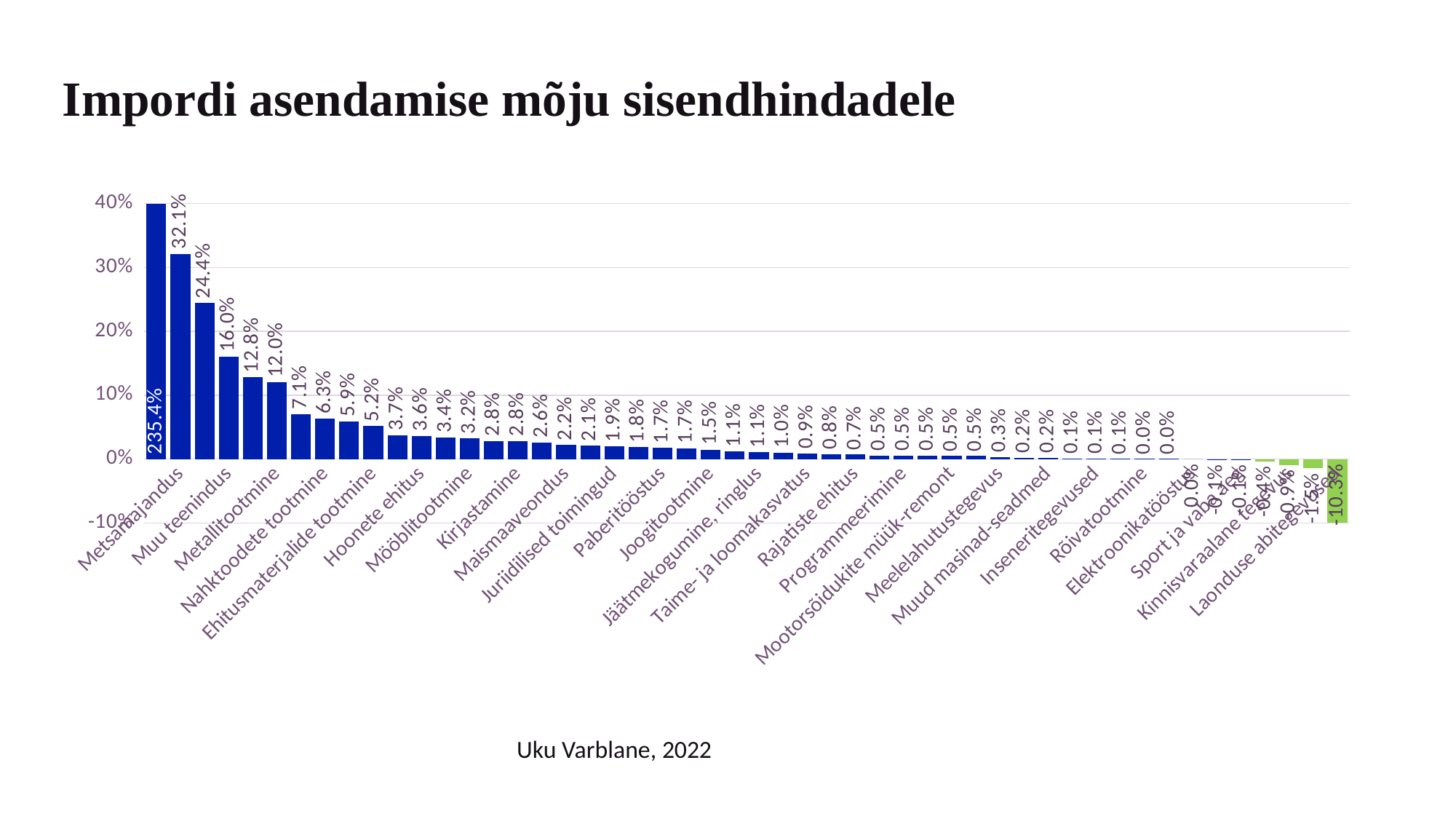
What colour are the bars with negative values? green How many bars have negative values? 6 What type of chart is shown on the slide? bar chart Do the bar values rise or fall moving from left to right along the x axis? fall What is the difference between the two highest labelled values, 235.4% and 32.1%? 203.3% What is the value shown for Metsamajandus? 32.1% Is the value for Metsamajandus greater or less than 40%? less What is the second-highest value labelled in the chart? 32.1% What is the title of the chart? Impordi asendamise mõju sisendhindadele Which is larger, the value for Metsamajandus or the value for Laonduse abitegevused? Metsamajandus What is the lowest value labelled in the chart? -10.3%